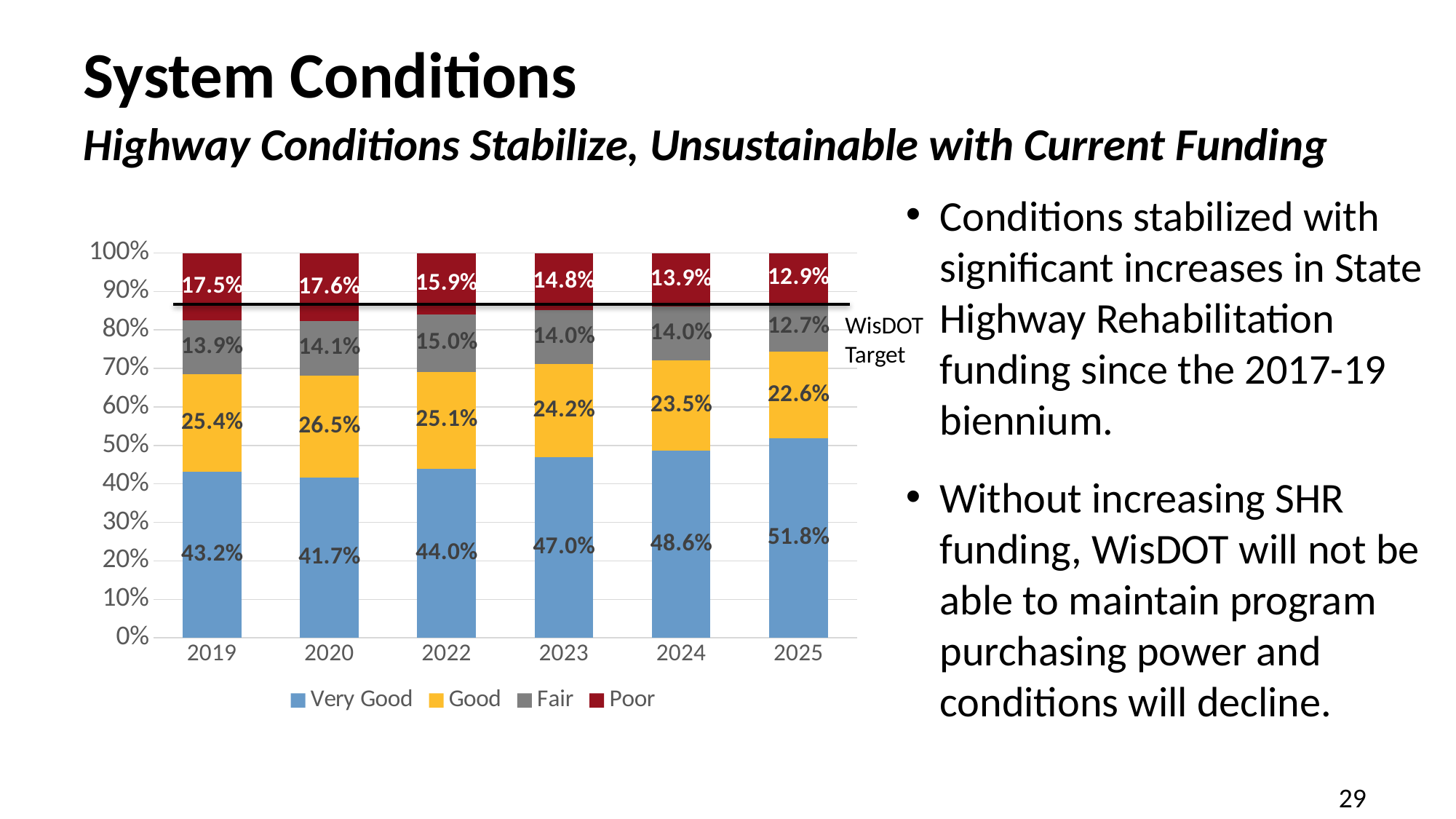
How many years are shown on the x axis of the chart? 6 How many series does the chart legend list? 4 By how many percentage points did the Very Good share increase from 2019 to 2025? 8.6 percentage points In which year is the Poor share the lowest? 2025 What is the Poor share shown for 2019? 17.5% What percentage of highways were in Very Good condition in 2025? 51.8% What is the Good share for 2020? 26.5% In 2019, which is larger: the Good share or the Fair share? Good Does the Poor share rise or fall from 2020 to 2025? Fall What value is shown for the Fair category in 2022? 15.0% What kind of chart is shown on the slide? Stacked bar chart In which year is the Very Good share the highest? 2025